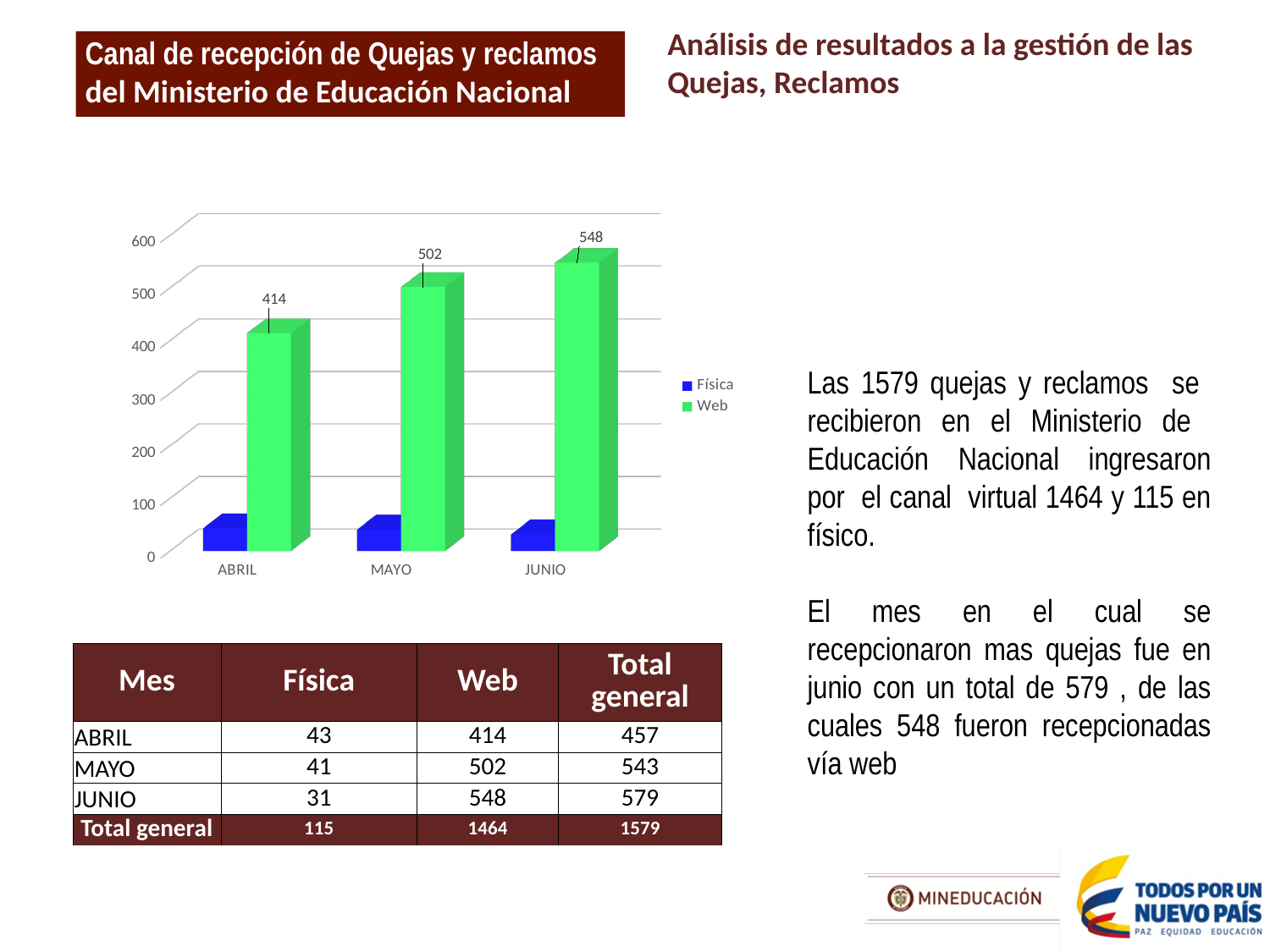
What is the Web value for MAYO in the bar chart? 502 What is the Web value for ABRIL in the bar chart? 414 How many months are shown on the x axis of the bar chart? 3 What is the difference between the Web values for JUNIO and ABRIL in the bar chart? 134 Which month has the lowest Web value in the bar chart? ABRIL Is the Física value for ABRIL greater or less than 100? less Which month has the highest Web value in the bar chart? JUNIO What is the Web value for JUNIO in the bar chart? 548 What kind of chart is shown on the slide? bar chart Do the Web values rise or fall from ABRIL to JUNIO? rise How many series does the chart legend list? 2 Is the Web value for MAYO larger or smaller than the Web value for JUNIO? smaller